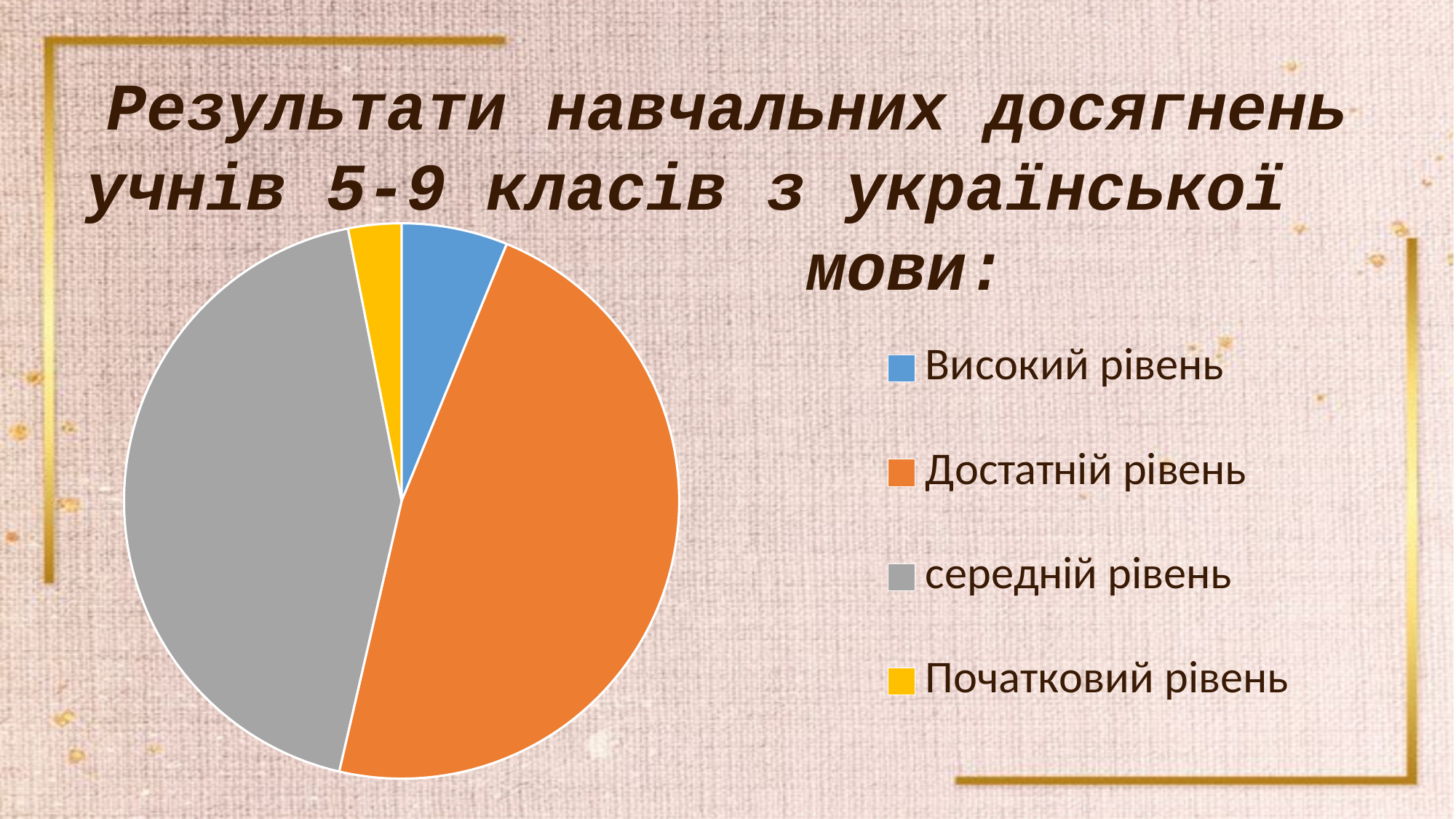
Which category has the smallest slice in the pie chart? Початковий рівень How many slices does the pie chart have? 4 How many entries does the legend of the pie chart list? 4 Which slice is larger in the pie chart: Достатній рівень or середній рівень? Достатній рівень What kind of chart is shown on the slide? pie chart Which slice is larger in the pie chart: Високий рівень or Початковий рівень? Високий рівень What colour is the slice for Початковий рівень in the pie chart? yellow Which category is shown in gray in the pie chart? середній рівень Which category has the largest slice in the pie chart? Достатній рівень Which slice is larger in the pie chart: середній рівень or Високий рівень? середній рівень